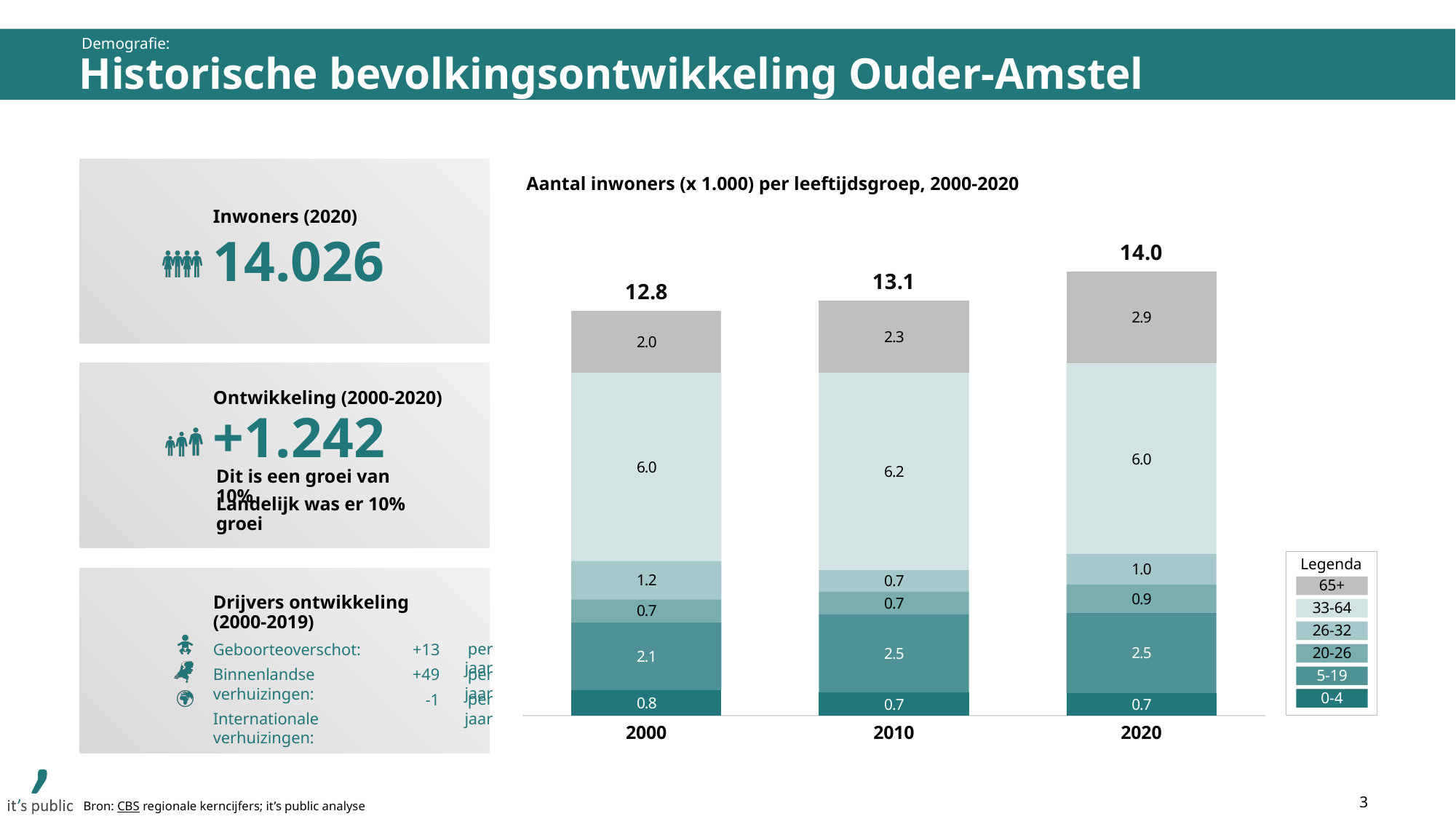
How many age groups does the legend list? 6 What is the value for the 65+ age group in 2010? 2.3 What is the total number of inhabitants (x 1.000) shown for 2020? 14.0 Which year has the lowest total number of inhabitants? 2000 What is the value for the 0-4 age group in 2020? 0.7 What type of chart is shown on the slide? Stacked bar chart Do the total inhabitants rise or fall from 2000 to 2020? Rise How much larger is the 65+ group in 2020 than in 2000? 0.9 What is the value for the 33-64 age group in 2000? 6.0 Which year has the highest total number of inhabitants? 2020 How many years (categories) are shown on the x axis? 3 Which is larger: the 26-32 group in 2000 or the 26-32 group in 2010? 2000